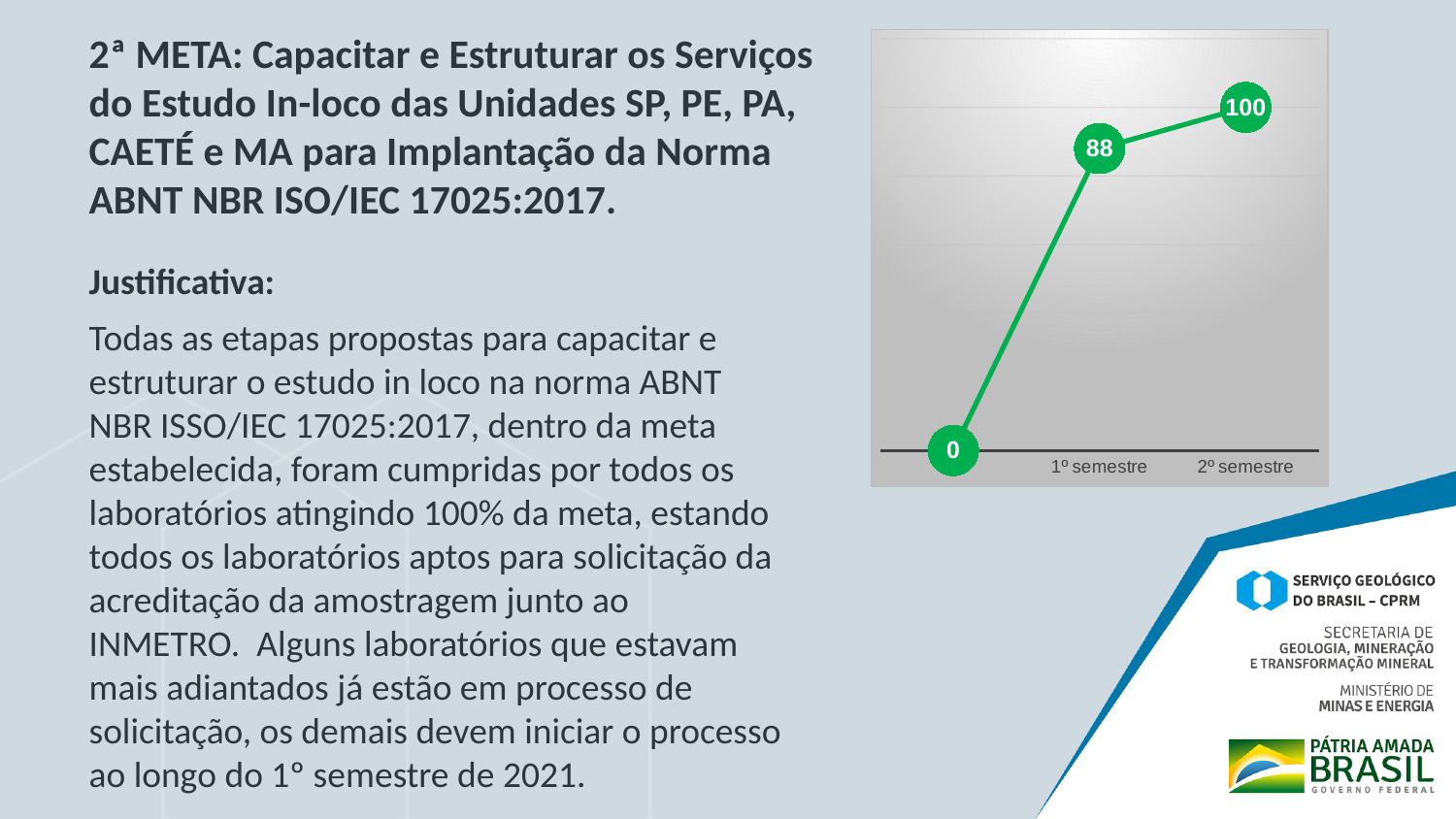
How many data points are plotted on the line? 3 Which labelled semester has the higher value, 1º semestre or 2º semestre? 2º semestre What is the value of the first (leftmost) data point on the line? 0 Do the values rise or fall from left to right along the x axis? rise What type of chart is shown on the slide? line chart Which point on the line has the highest value? 2º semestre What is the value plotted for 2º semestre? 100 What is the value plotted for 1º semestre? 88 What is the difference between the value for 1º semestre and the first data point? 88 What is the difference between the values for 2º semestre and 1º semestre? 12 What colour is the line in the chart? green